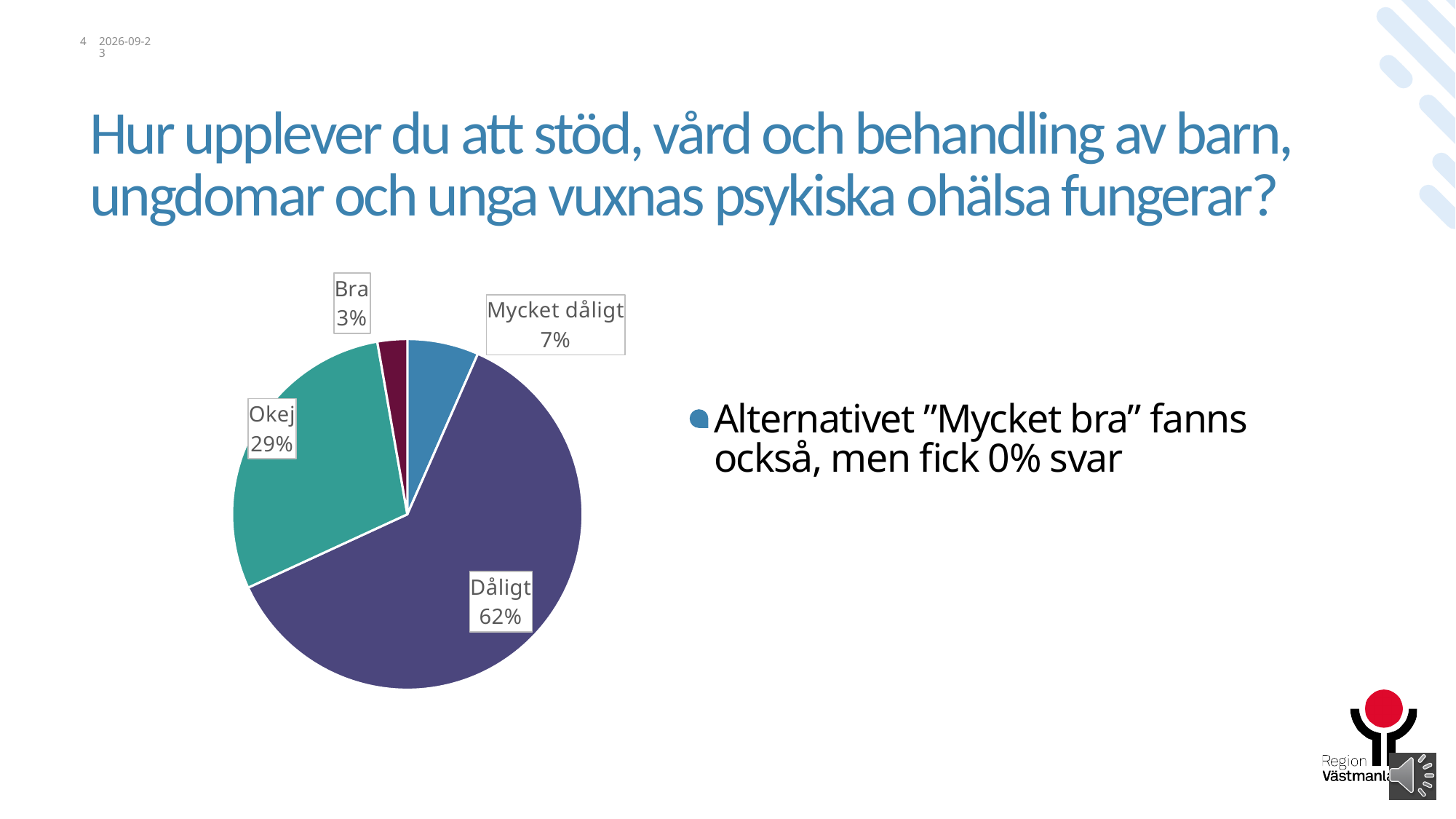
What is the combined share of "Dåligt" and "Mycket dåligt"? 69% What share of the pie does "Bra" have? 3% What share of the pie does "Mycket dåligt" have? 7% What kind of chart is shown on the slide? Pie chart Which category has the largest slice of the pie? Dåligt What share of the pie does "Dåligt" have? 62% Which is larger, the share for "Mycket dåligt" or the share for "Bra"? Mycket dåligt Which category has the smallest slice of the pie? Bra What colour is the "Okej" slice of the pie? Teal (green) What is the difference in percentage points between "Dåligt" and "Okej"? 33 How many slices does the pie chart have? 4